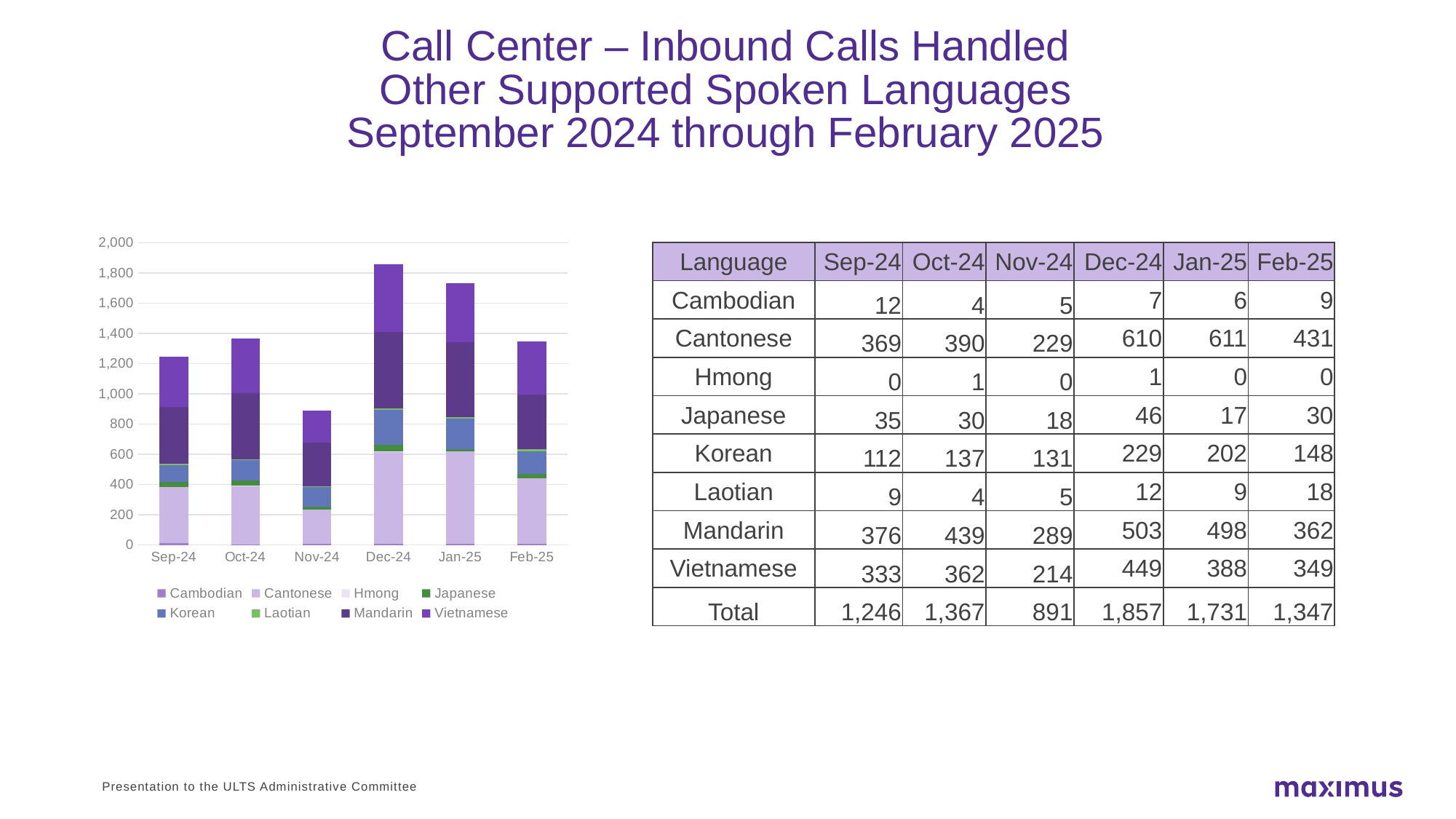
How many months are plotted along the x axis of the chart? 6 Which month has the shortest stacked bar in the chart? Nov-24 What is the total of the stacked bar for Nov-24? 891 Which month has the tallest stacked bar in the chart? Dec-24 How many Mandarin calls were handled in Jan-25? 498 Which is larger, the Korean value for Dec-24 or the Korean value for Feb-25? Dec-24 What is the difference between the Dec-24 total and the Jan-25 total? 126 What is the total of the stacked bar for Dec-24? 1,857 How many Cantonese calls were handled in Feb-25? 431 How many languages does the chart legend list? 8 What kind of chart is shown on the slide? Stacked bar chart Is the total for Oct-24 greater or less than 1,200? greater